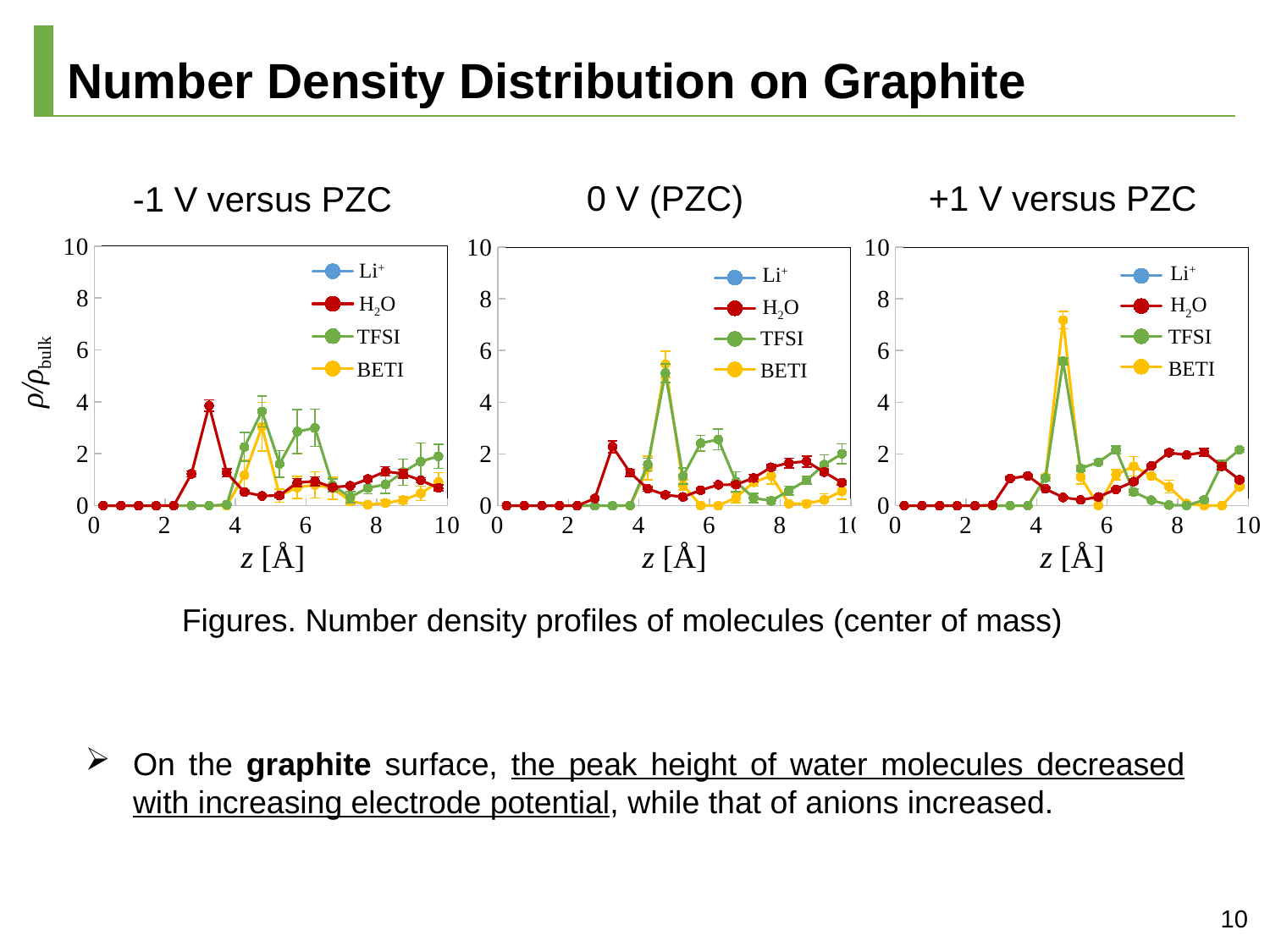
In the "+1 V versus PZC" chart, which series reaches the highest peak? BETI In the "-1 V versus PZC" chart, is the peak value of H2O greater or less than 2? greater Which series is shown in blue in the legend of the "-1 V versus PZC" chart? Li+ What kind of chart is used in each of the three panels on the slide? line chart Is the peak of H2O higher in the "-1 V versus PZC" chart or in the "+1 V versus PZC" chart? -1 V versus PZC In the "+1 V versus PZC" chart, is the peak value of BETI greater or less than 6? greater How many series does the legend of the "0 V (PZC)" chart list? 4 In the "0 V (PZC)" chart, is the peak value of TFSI greater or less than 4? greater How many charts are shown on the slide? 3 What is the x-axis label of the charts? z [Å] In the "+1 V versus PZC" chart, which has the higher peak, BETI or H2O? BETI